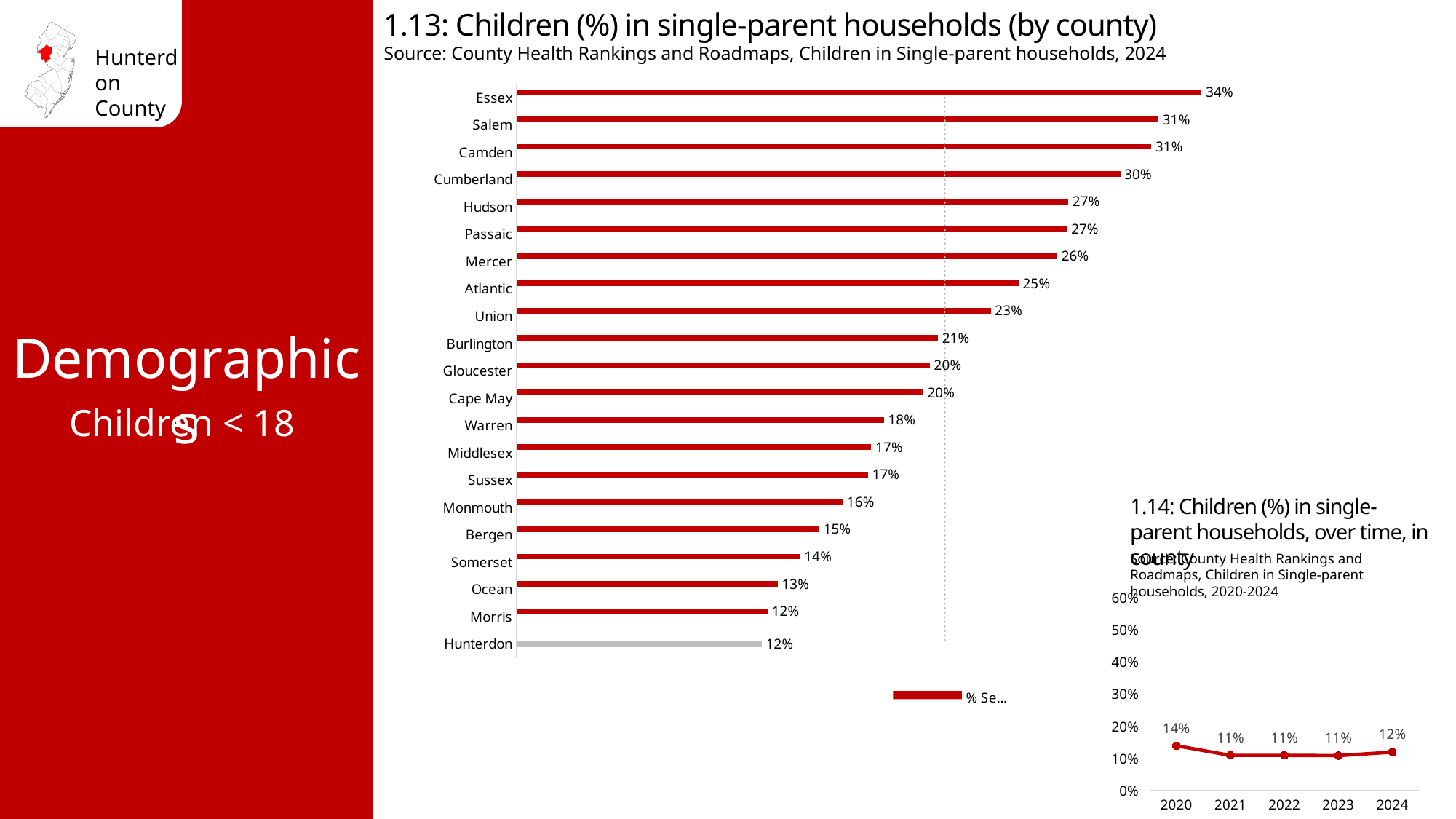
In chart 1.14, how many years are plotted? 5 In chart 1.13 (Children in single-parent households by county), what is the value for Essex? 34% In chart 1.13, what is the value for Hunterdon? 12% In chart 1.14 (Children in single-parent households over time), what is the value for 2020? 14% In chart 1.13, which is larger, the value for Hudson or the value for Union? Hudson In chart 1.14, what is the value for 2024? 12% In chart 1.13, what is the difference between the values for Essex and Hunterdon? 22 percentage points In chart 1.13, how many counties are shown? 21 What kind of chart is chart 1.13? Bar chart In chart 1.13, which county has the highest percentage of children in single-parent households? Essex What kind of chart is chart 1.14? Line chart In chart 1.13, what is the value for Cumberland? 30%